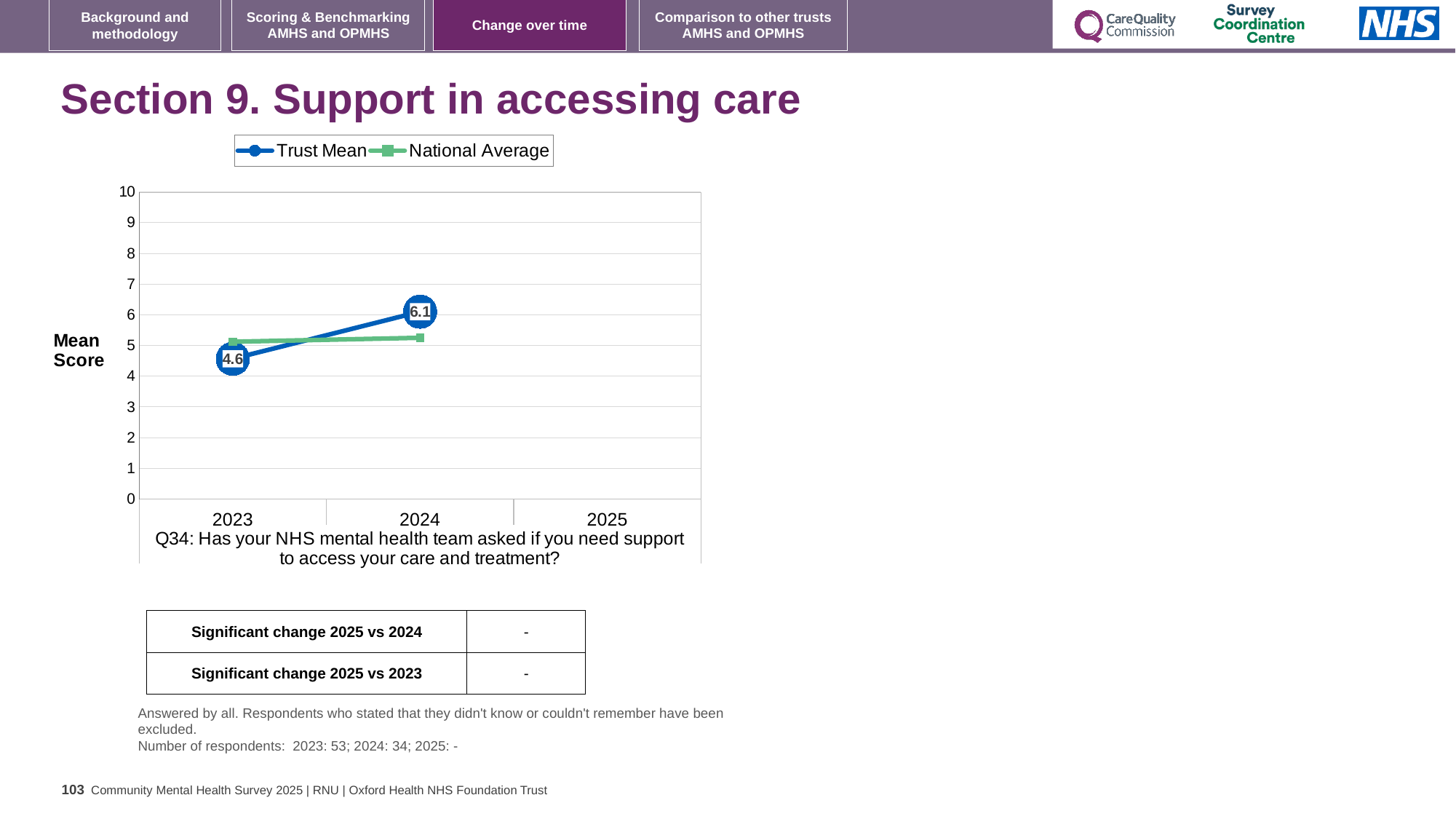
By how much did the Trust Mean change from 2023 to 2024? 1.5 What is the label on the y axis of the chart? Mean Score What is the Trust Mean value for 2023? 4.6 Is the National Average value for 2024 greater or less than 6? less What kind of chart is shown on the slide? line chart How many series does the legend list? 2 Does the Trust Mean rise or fall from 2023 to 2024? rise What is the Trust Mean value for 2024? 6.1 In 2023, which is higher: the Trust Mean or the National Average? National Average In 2024, which is higher: the Trust Mean or the National Average? Trust Mean How many years are shown on the x axis? 3 Which year has the higher Trust Mean, 2023 or 2024? 2024